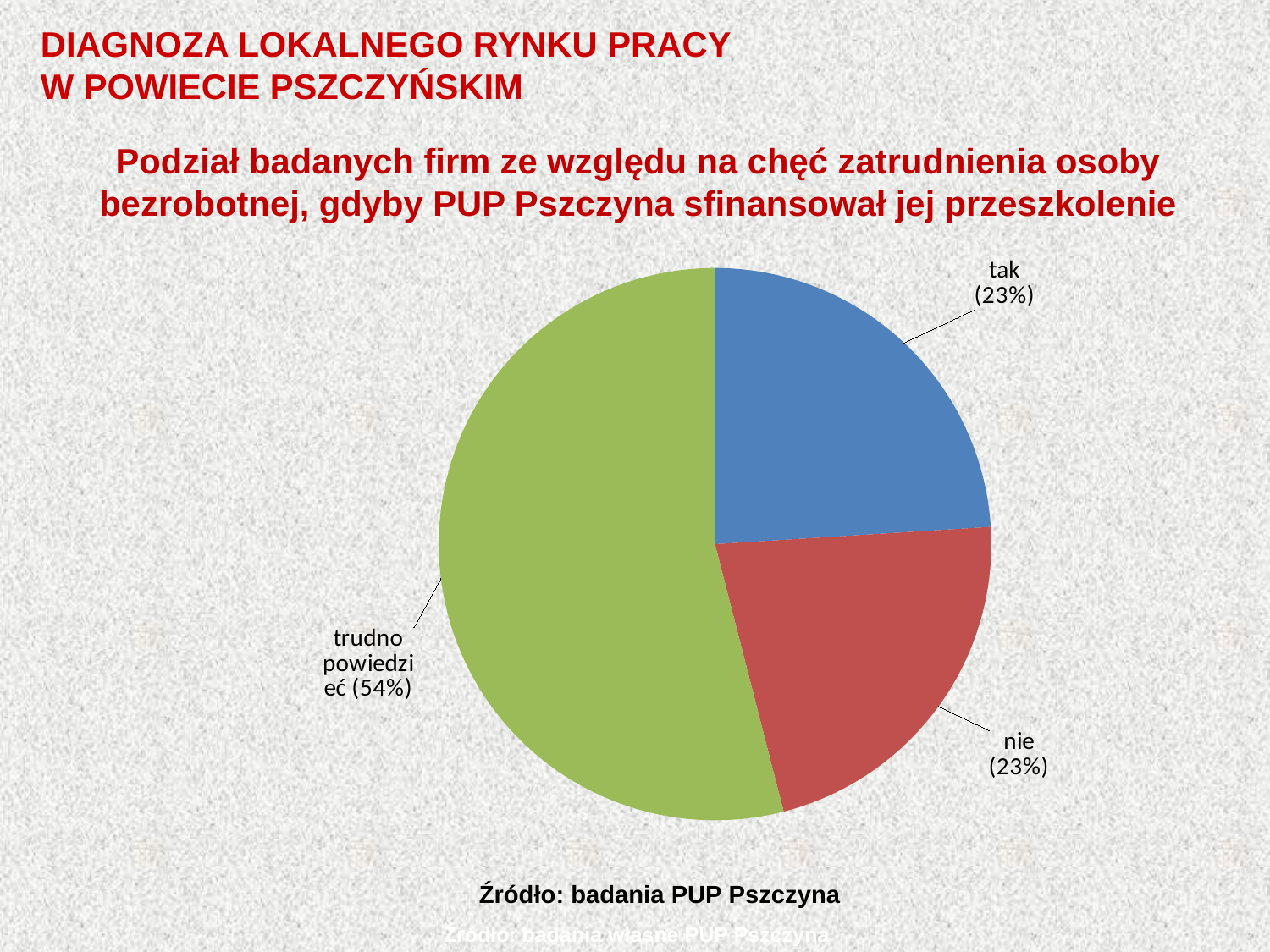
What percentage of surveyed firms answered "nie"? 23% What kind of chart is shown on the slide? pie chart How many slices does the pie chart have? 3 Is the share for "tak" larger than, smaller than, or equal to the share for "nie"? equal What source is given below the chart? Źródło: badania PUP Pszczyna What share of the pie does the "trudno powiedzieć" slice take? 54% What percentage of surveyed firms answered "tak"? 23% Is the share for "trudno powiedzieć" greater or less than 50%? greater What colour is the "tak" slice of the pie? blue By how many percentage points does "trudno powiedzieć" exceed "tak"? 31 percentage points Which answer category has the largest share of the pie? trudno powiedzieć What percentage of surveyed firms answered "trudno powiedzieć"? 54%